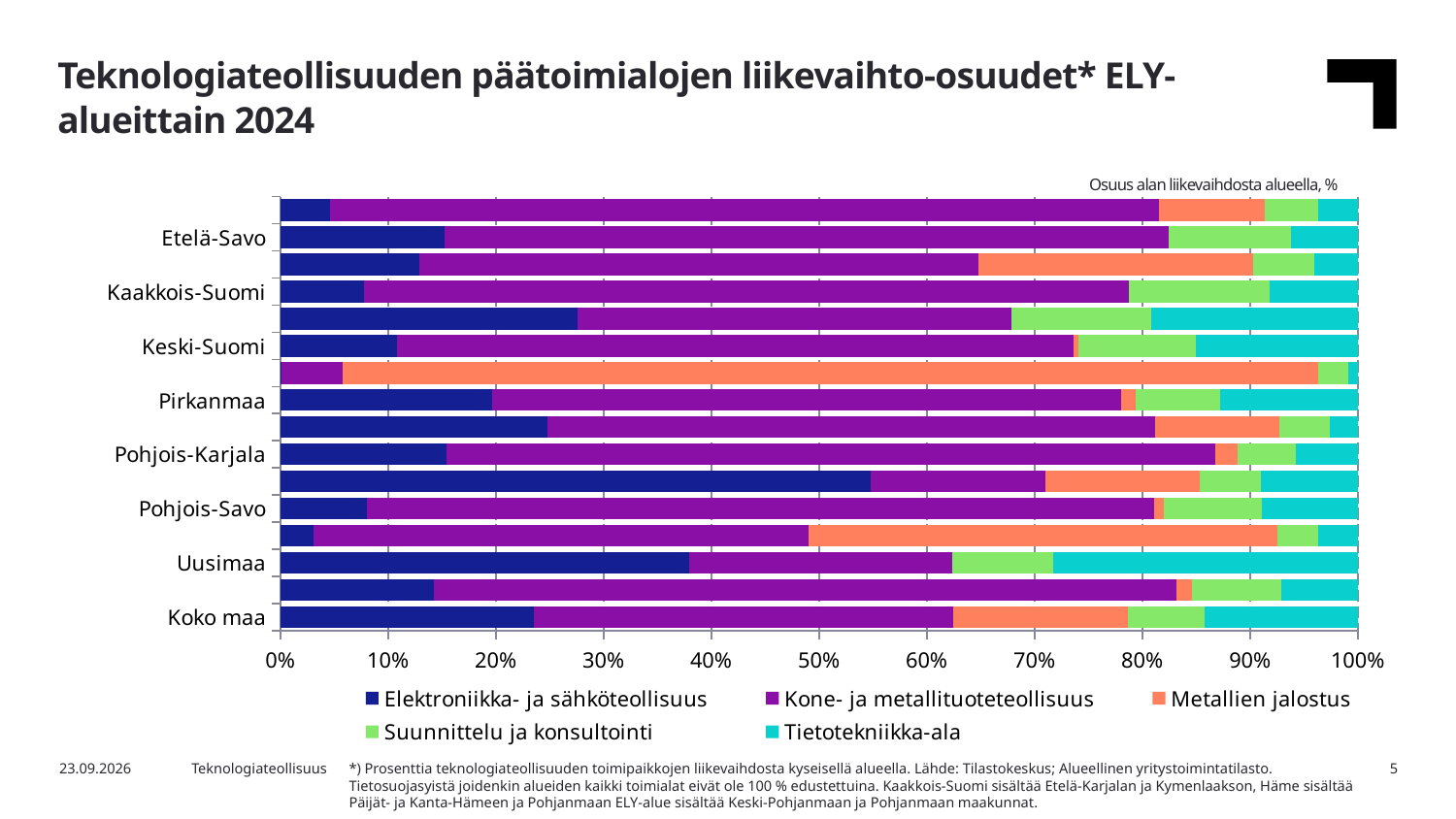
How many series does the legend list? 5 Which has the larger Kone- ja metallituoteteollisuus share, Koko maa or Uusimaa? Koko maa Which has the larger Tietotekniikka-ala share, Uusimaa or Koko maa? Uusimaa Which series is listed first in the legend? Elektroniikka- ja sähköteollisuus Is the Elektroniikka- ja sähköteollisuus share for Pohjois-Karjala greater or less than 20%? less Is the Elektroniikka- ja sähköteollisuus share for Uusimaa greater or less than 30%? greater Which has the larger Elektroniikka- ja sähköteollisuus share, Uusimaa or Koko maa? Uusimaa Is the Elektroniikka- ja sähköteollisuus share for Kaakkois-Suomi greater or less than 10%? less What kind of chart is shown on the slide? Stacked horizontal bar chart How many stacked bars are plotted in the chart? 16 What is the maximum value shown on the x axis? 100%